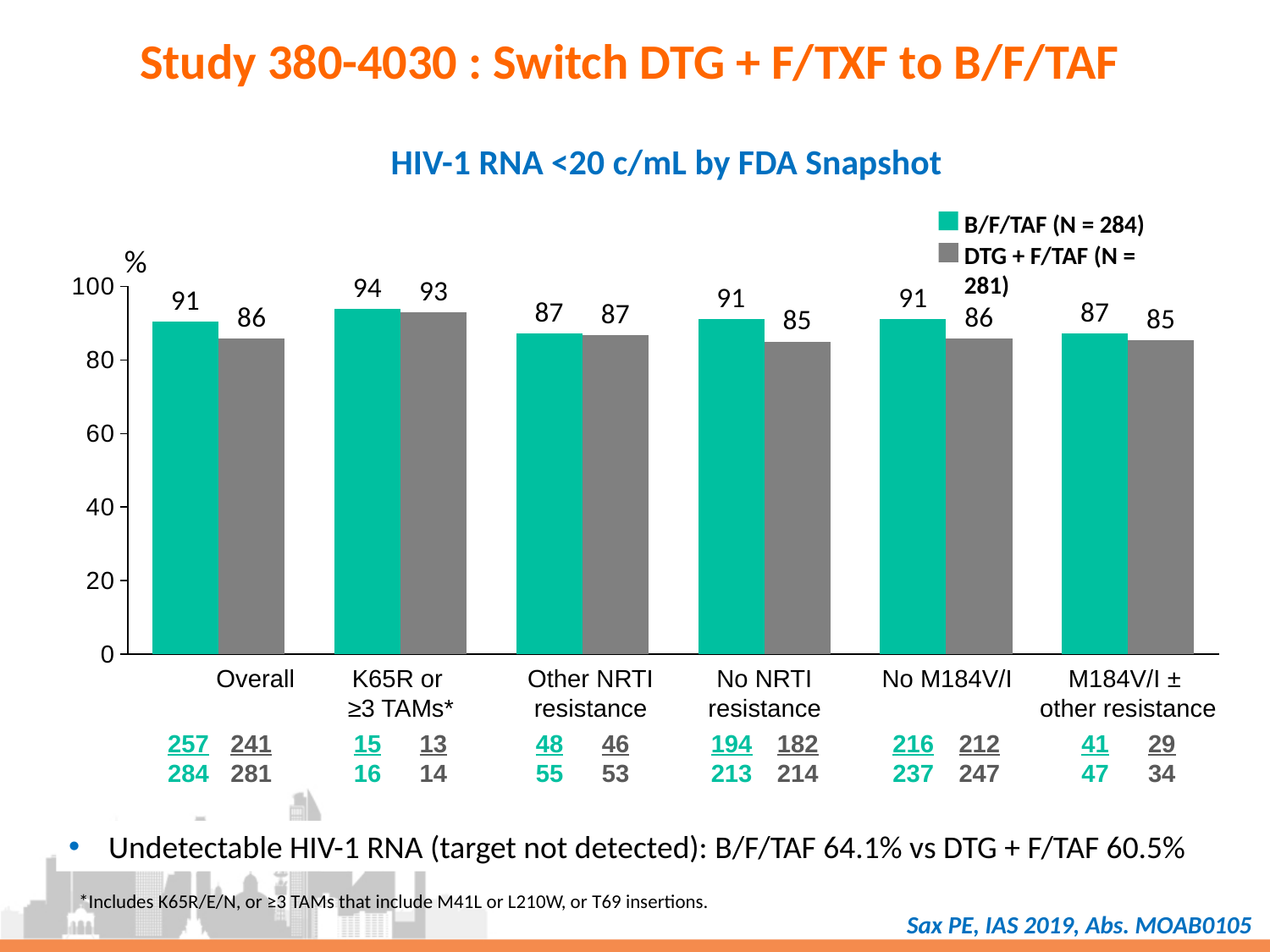
What is the title of the chart? HIV-1 RNA <20 c/mL by FDA Snapshot Is the value for DTG + F/TAF in the M184V/I ± other resistance category greater or less than 80? greater How many categories are shown on the x axis of the chart? 6 What is the difference between the B/F/TAF and DTG + F/TAF values in the Overall category? 5 How many series does the legend list? 2 What is the value for B/F/TAF in the Overall category? 91 What is the value for DTG + F/TAF in the No NRTI resistance category? 85 Which category has the highest value for B/F/TAF? K65R or ≥3 TAMs* What is the value for DTG + F/TAF in the K65R or ≥3 TAMs* category? 93 In the No NRTI resistance category, which series has the larger value, B/F/TAF or DTG + F/TAF? B/F/TAF What kind of chart is shown on the slide? Bar chart Which category has the highest value for DTG + F/TAF? K65R or ≥3 TAMs*